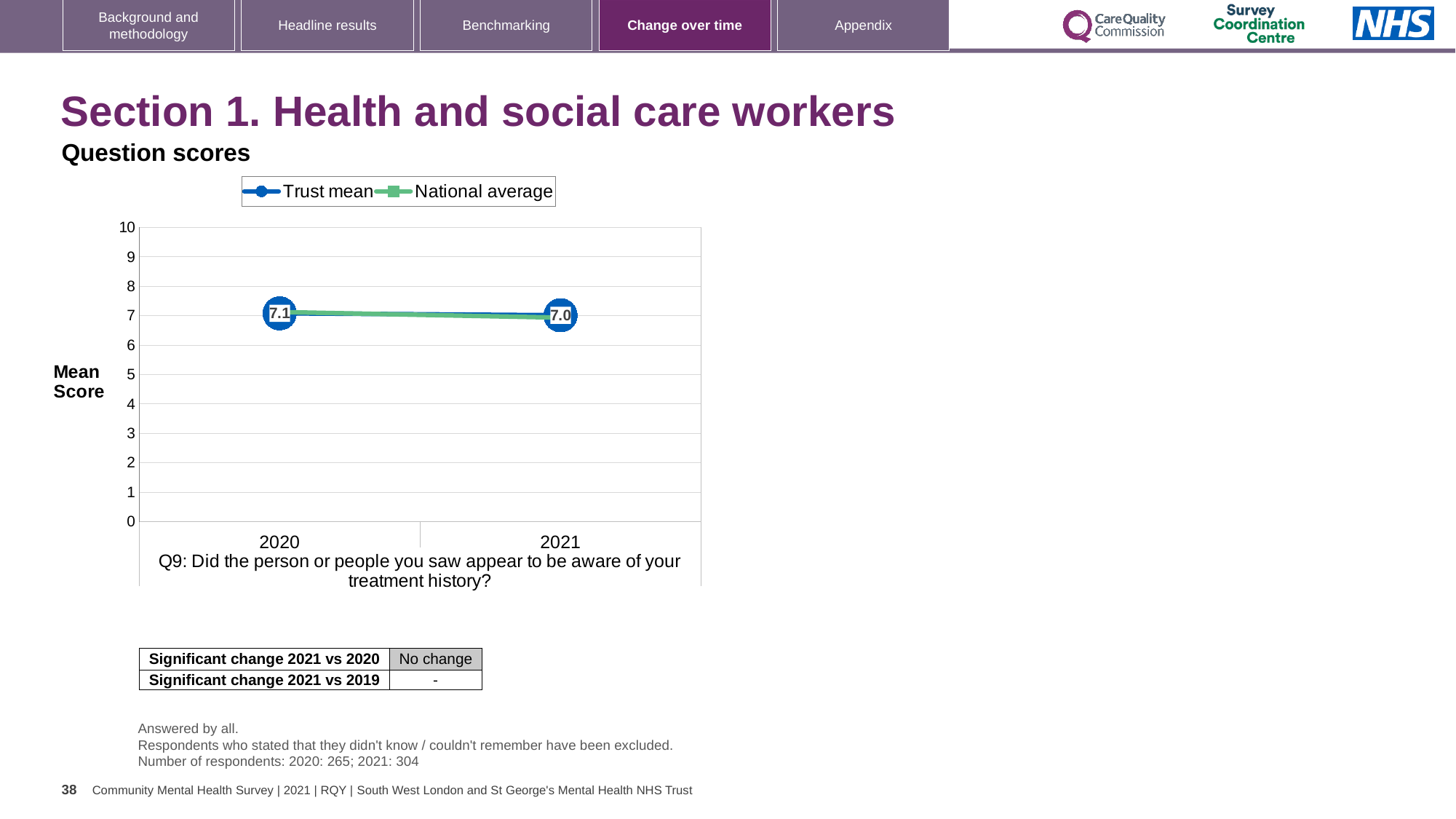
Does the Trust mean rise or fall from 2020 to 2021? fall How many years are plotted on the x axis? 2 What kind of chart is shown on the slide? line chart Which year has the higher Trust mean, 2020 or 2021? 2020 What is the Trust mean score for 2021? 7.0 By how much did the Trust mean change from 2020 to 2021? 0.1 What are the two series named in the legend? Trust mean and National average What is the Trust mean score for 2020? 7.1 Is the National average value for 2021 greater or less than 5? greater How many series does the legend list? 2 What is the label on the y axis of the chart? Mean Score Is the Trust mean value for 2020 greater or less than 8? less